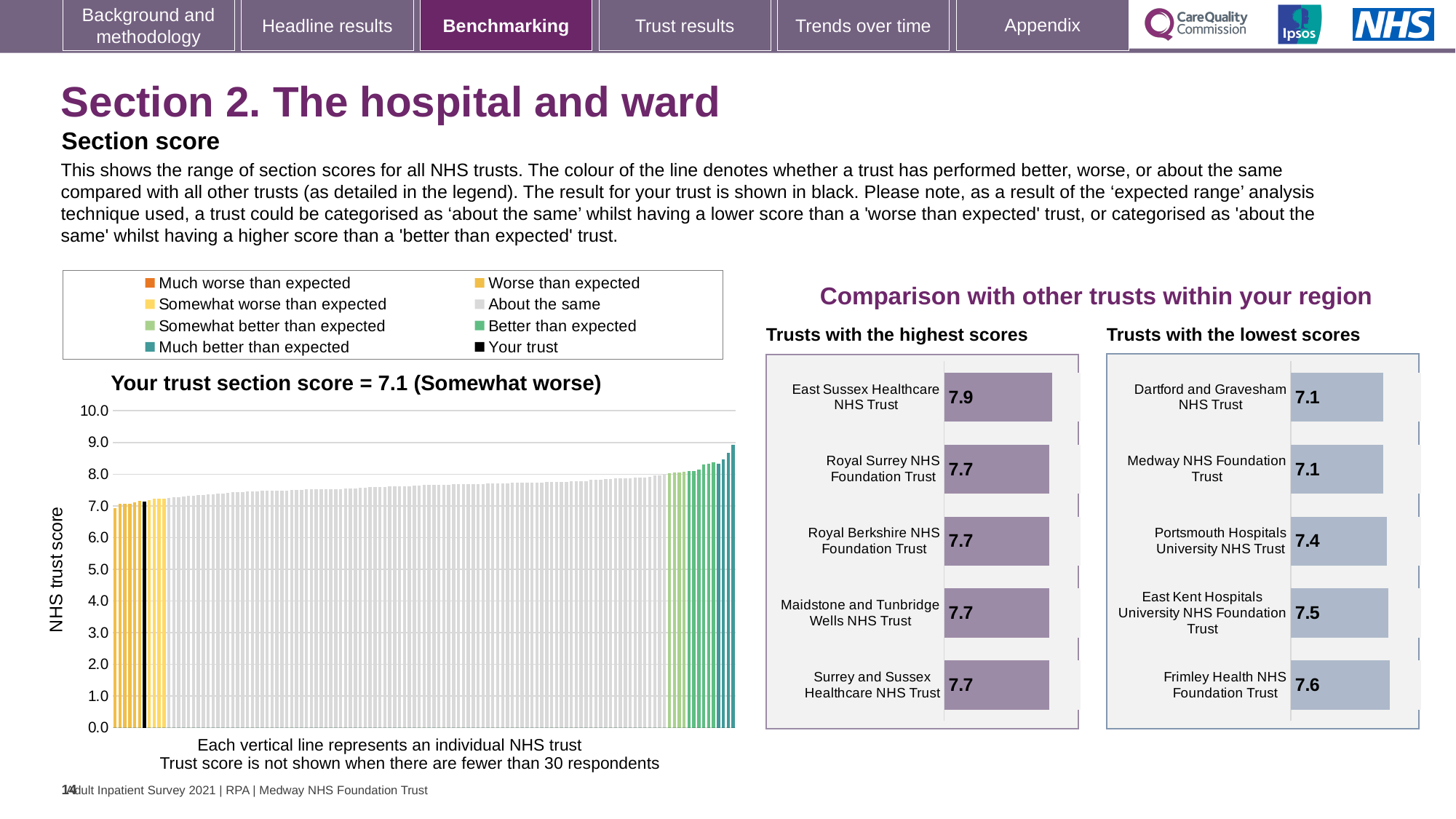
In the 'Trusts with the highest scores' chart, what is the score for East Sussex Healthcare NHS Trust? 7.9 In the 'Trusts with the highest scores' chart, what is the difference between the scores of East Sussex Healthcare NHS Trust and Royal Surrey NHS Foundation Trust? 0.2 In the 'Trusts with the lowest scores' chart, which has the larger score: Portsmouth Hospitals University NHS Trust or East Kent Hospitals University NHS Foundation Trust? East Kent Hospitals University NHS Foundation Trust How many entries does the legend above the 'Your trust section score' chart list? 8 In the 'Trusts with the highest scores' chart, how many trusts are shown? 5 In the 'Trusts with the lowest scores' chart, which trust has the highest score? Frimley Health NHS Foundation Trust In the 'Trusts with the lowest scores' chart, what is the score for Portsmouth Hospitals University NHS Trust? 7.4 In the 'Trusts with the lowest scores' chart, what is the score for Medway NHS Foundation Trust? 7.1 What kind of chart is the 'Your trust section score' chart on the left? Bar chart In the 'Trusts with the lowest scores' chart, what is the difference between the scores of Frimley Health NHS Foundation Trust and Portsmouth Hospitals University NHS Trust? 0.2 In the 'Your trust section score' chart, is the value for your trust (the black bar) greater or less than 8.0? less In the 'Trusts with the highest scores' chart, which trust has the highest score? East Sussex Healthcare NHS Trust